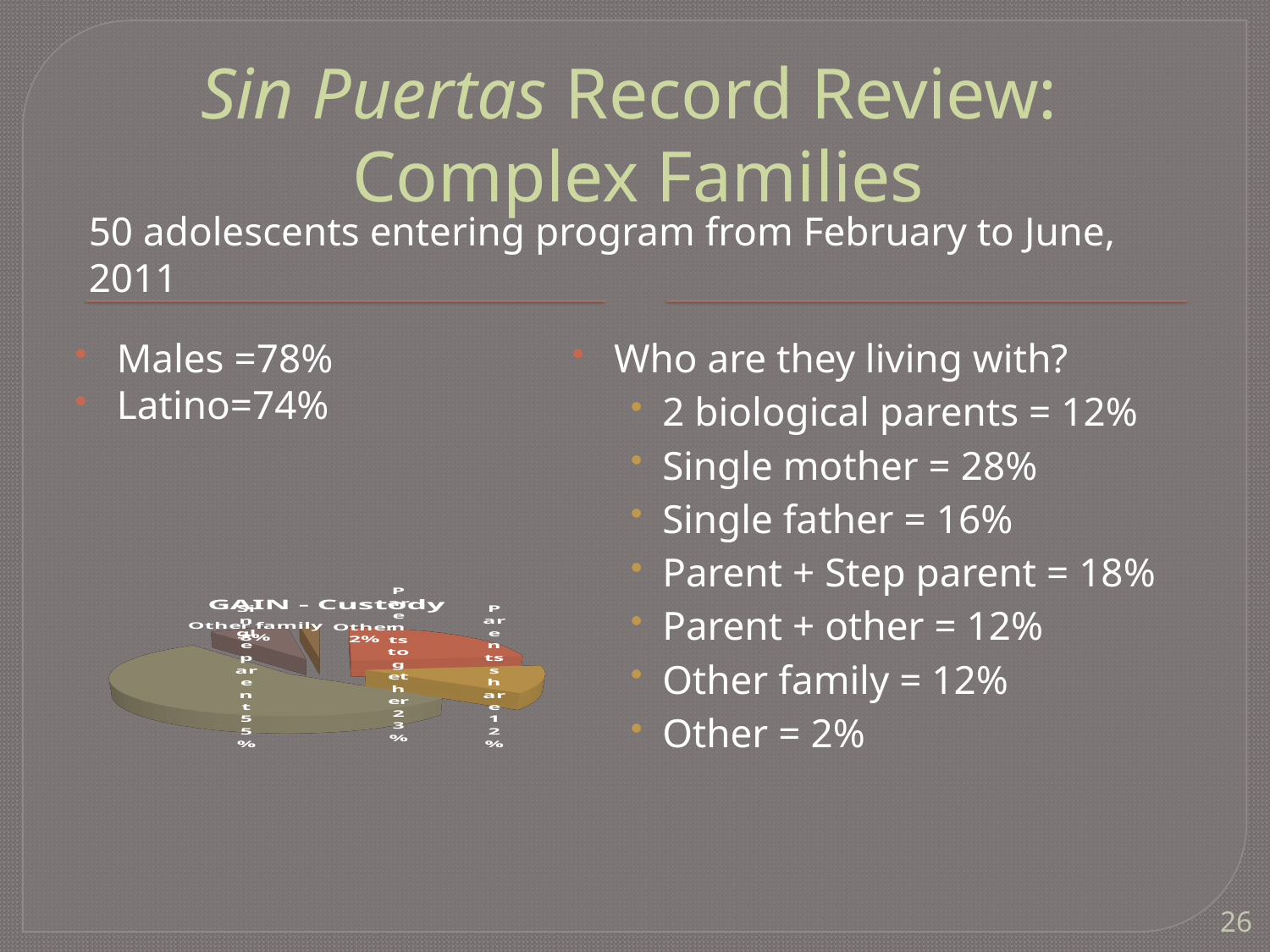
In the GAIN - Custody pie chart, what share is labelled for the "Other" slice? 2% In the GAIN - Custody pie chart, which slice is the smallest? Other In the GAIN - Custody pie chart, what share is labelled for the "Other family" slice? 8% How many slices does the GAIN - Custody pie chart have? 5 In the GAIN - Custody pie chart, is the "Other" slice greater or less than 5%? less What kind of chart is shown on the slide? pie chart What is the title of the chart on the slide? GAIN - Custody In the GAIN - Custody pie chart, which slice is larger: "Other family" or "Other"? Other family In the GAIN - Custody pie chart, what is the difference between the "Other family" share and the "Other" share? 6 percentage points